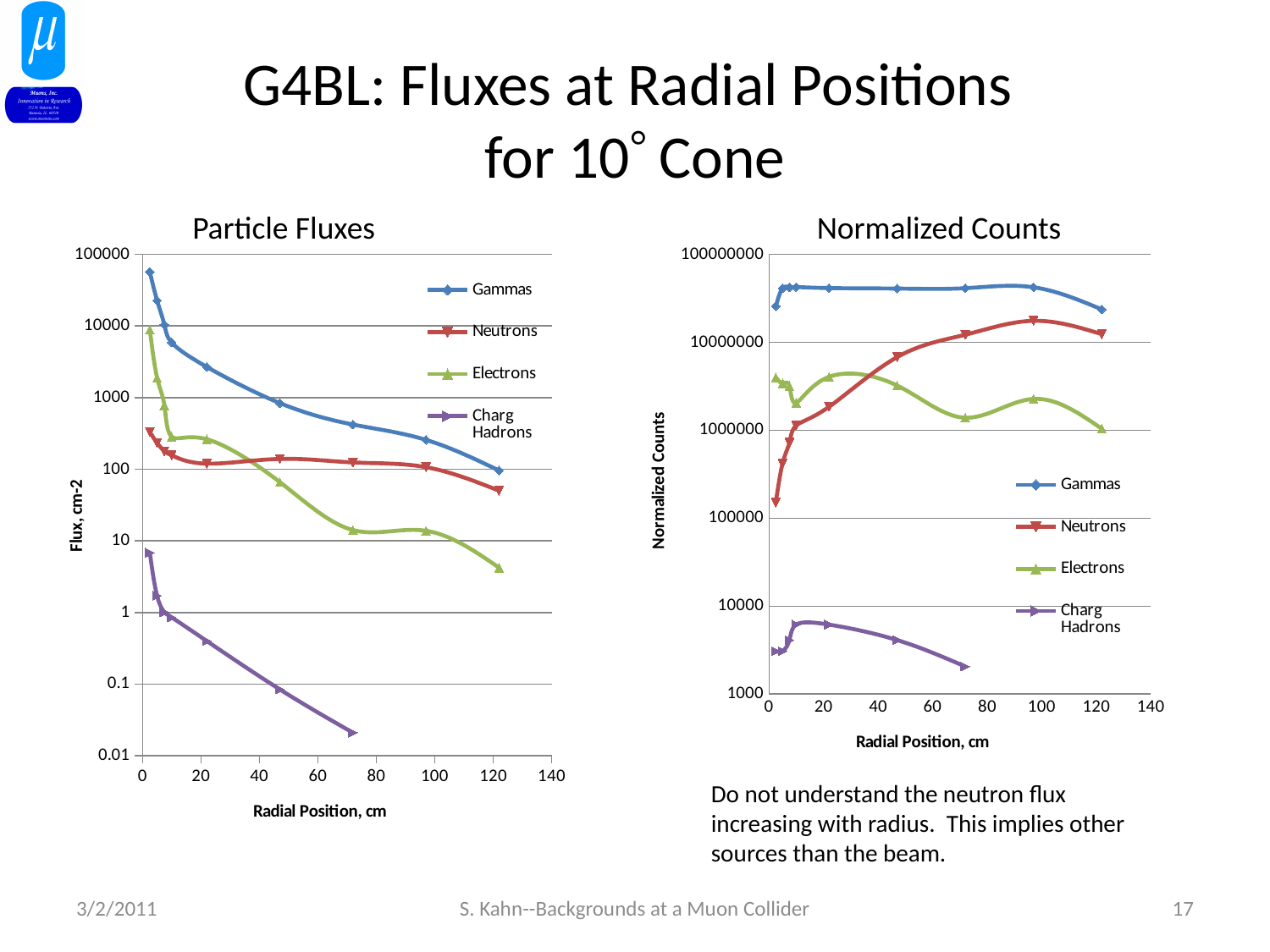
What is the x-axis title of the Normalized Counts chart? Radial Position, cm In the Particle Fluxes chart, which series has the lowest flux values across the radial positions? Charg Hadrons What kind of chart is the Particle Fluxes chart? line chart How many series does the legend of the Normalized Counts chart list? 4 In the Particle Fluxes chart, at about 122 cm, which is larger: the Gammas flux or the Electrons flux? Gammas In the Particle Fluxes chart, is the Charg Hadrons flux at about 72 cm greater or less than 0.1? less In the Particle Fluxes chart, do the Gammas values rise or fall as radial position increases? fall In the Normalized Counts chart, is the Gammas value at about 100 cm greater or less than 10000000? greater In the Particle Fluxes chart, is the Gammas flux at the smallest radial position greater or less than 10000? greater In the Normalized Counts chart, do the Neutrons values rise or fall as radial position increases? rise In the Particle Fluxes chart, which series has the highest flux values across the radial positions? Gammas